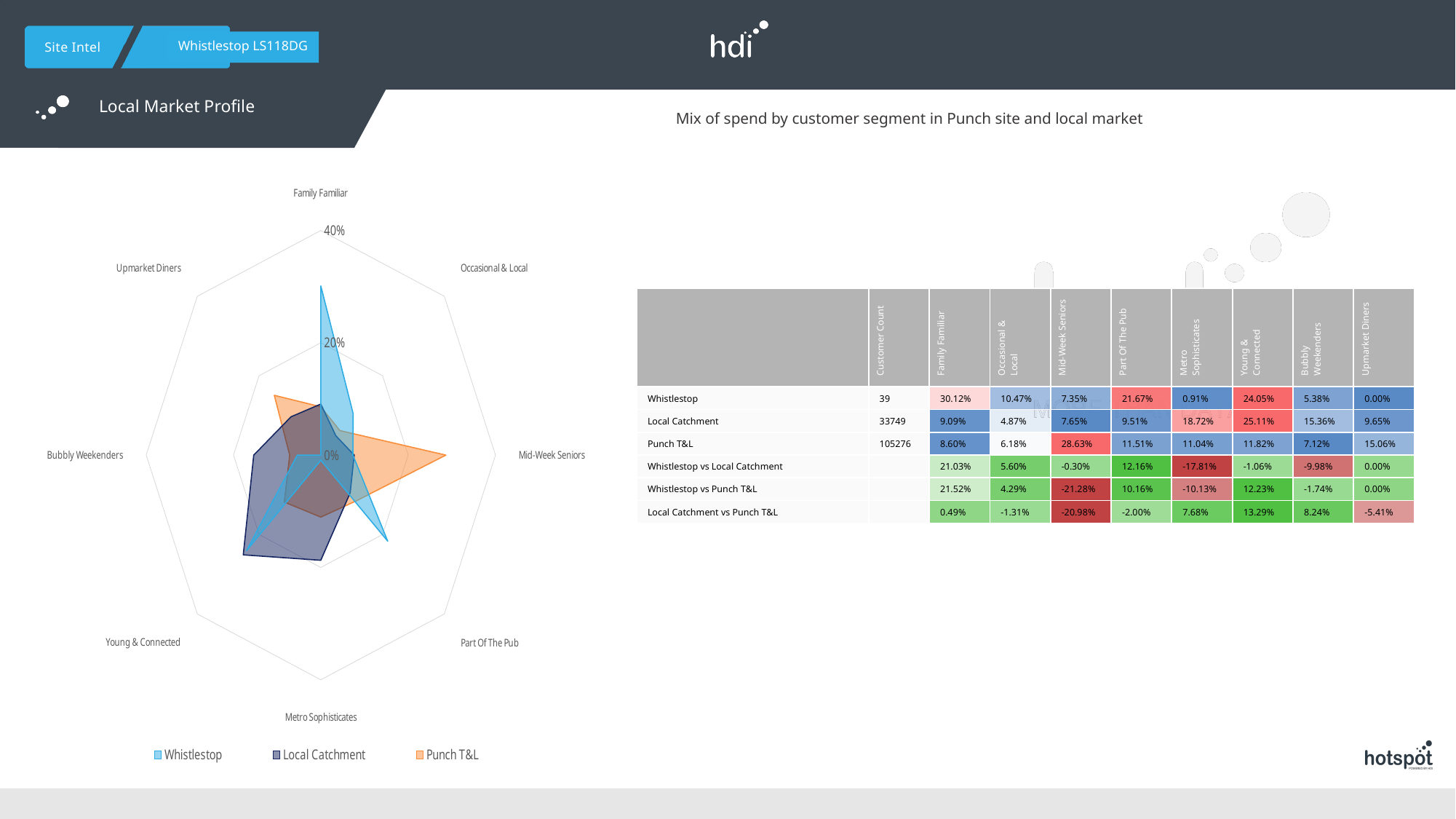
How many series does the radar chart's legend list? 3 For Mid-Week Seniors, which is larger: the Punch T&L value or the Whistlestop value? Punch T&L How many customer segments are plotted around the radar chart? 8 Which segment has the lowest value for the Whistlestop series? Upmarket Diners What is the Punch T&L value for Mid-Week Seniors? 28.63% What is the Whistlestop value for Family Familiar? 30.12% What is the difference between the Whistlestop and Local Catchment values for Family Familiar? 21.03% Is the Whistlestop value for Family Familiar greater or less than 20%? greater What kind of chart is shown on the left of the slide? Radar chart What is the Local Catchment value for Young & Connected? 25.11% Which segment has the highest value for the Whistlestop series? Family Familiar Which segment has the highest value for the Punch T&L series? Mid-Week Seniors